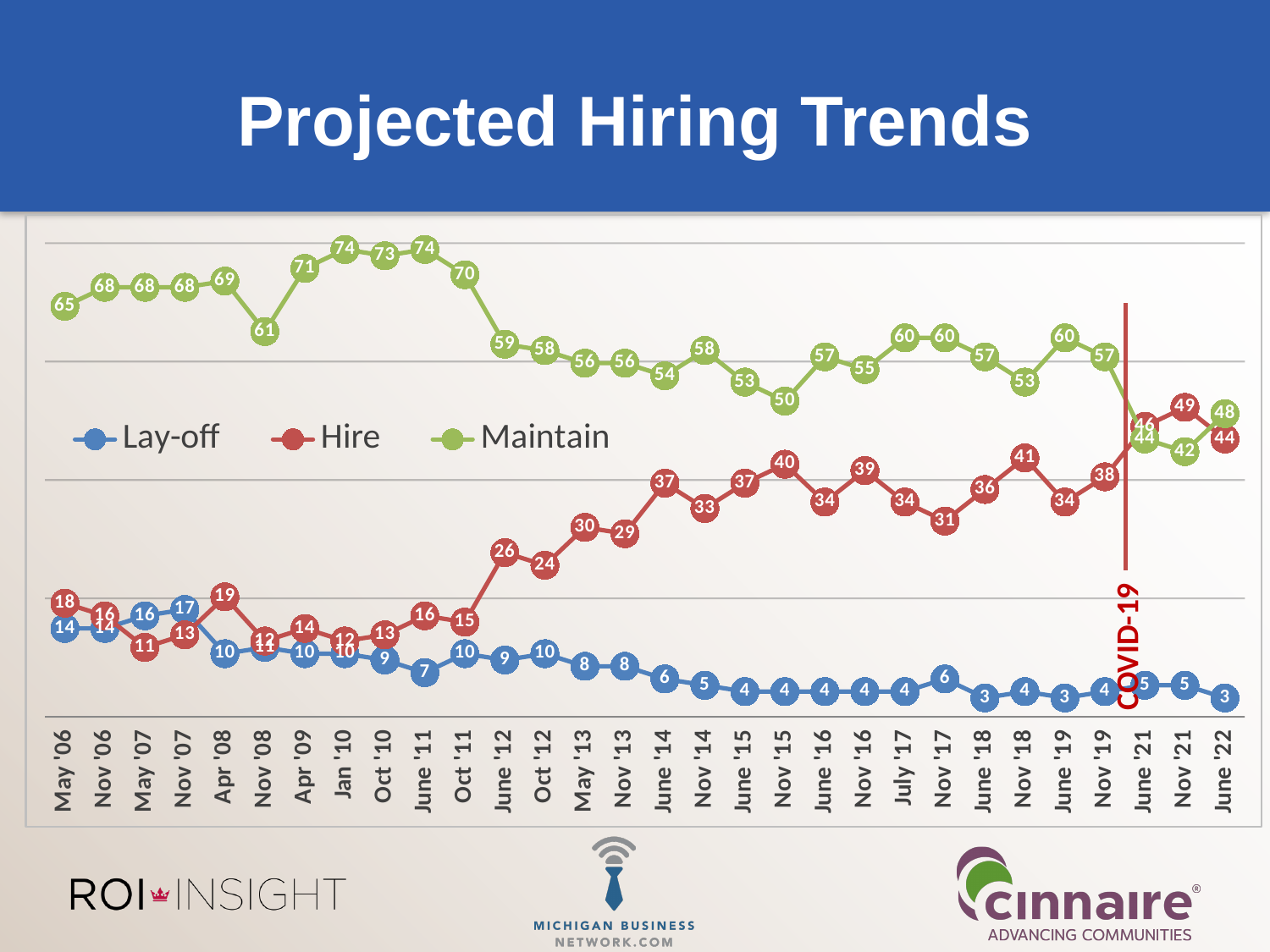
What label is written next to the vertical red line on the chart? COVID-19 What kind of chart is shown on the slide? line chart What is the Hire value at Nov '15? 40 Does the Hire series generally rise or fall from May '06 to June '22? rise What is the highest value reached by the Lay-off series? 17 What is the Lay-off value at June '22? 3 What is the difference between the Hire value and the Lay-off value at June '22? 41 At which date does the Hire series reach its highest value? Nov '21 What is the Maintain value at Jan '10? 74 At which date does the Maintain series reach its lowest value? Nov '21 How many series does the legend list? 3 At June '22, which is larger: the Maintain value or the Hire value? Maintain